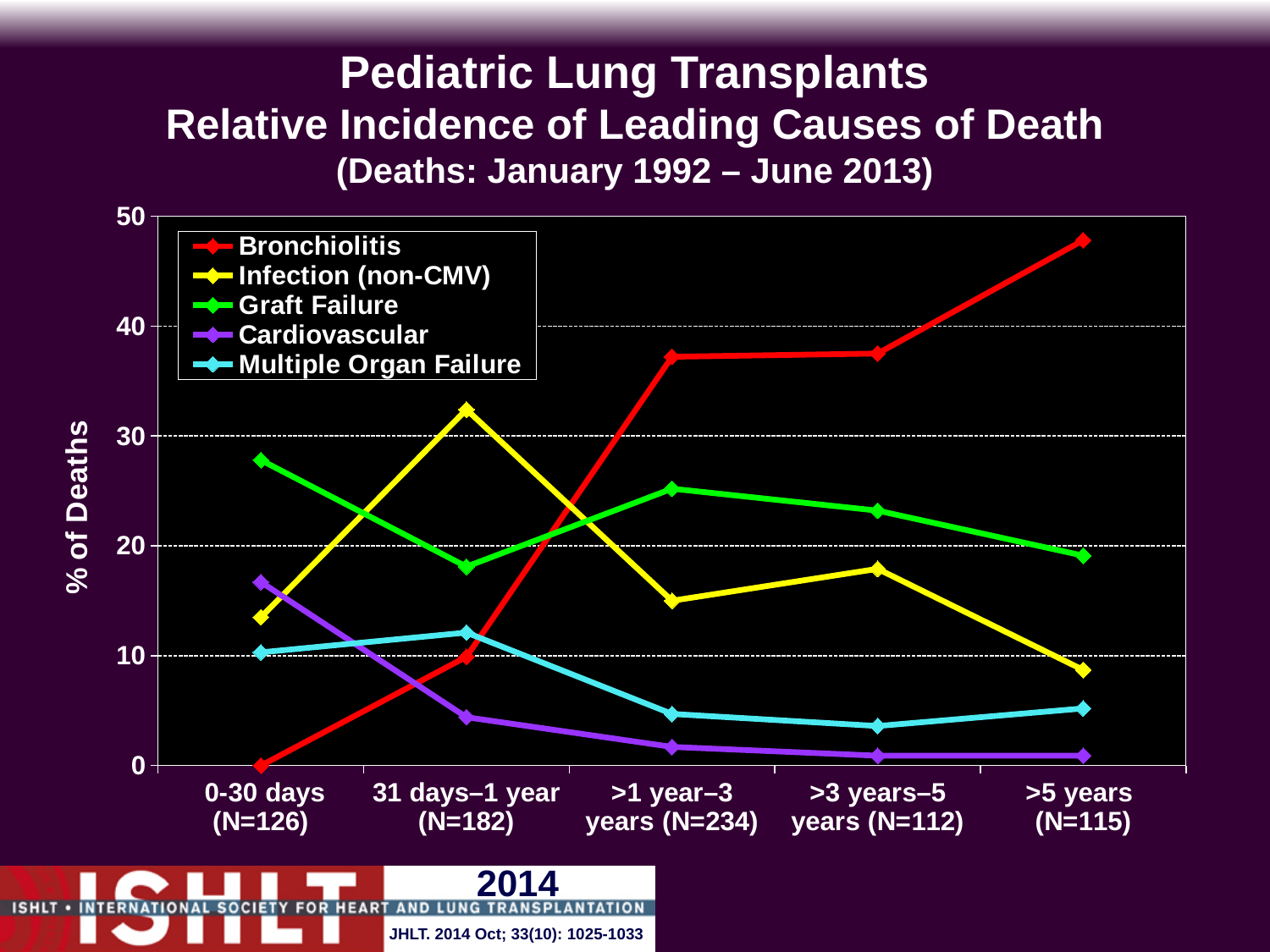
How many time-period categories are shown on the x axis? 5 Is the value for Infection (non-CMV) in the >5 years (N=115) period greater or less than 10? less Is the value for Bronchiolitis in the >5 years (N=115) period greater or less than 40? greater How many series does the legend list? 5 Which cause of death has the highest % of deaths in the 31 days–1 year (N=182) period? Infection (non-CMV) Which cause of death has the highest % of deaths in the 0-30 days (N=126) period? Graft Failure What is the label of the y axis? % of Deaths Which cause of death has the highest % of deaths in the >5 years (N=115) period? Bronchiolitis What kind of chart is shown on the slide? line chart In the >1 year–3 years (N=234) period, which is larger: Graft Failure or Infection (non-CMV)? Graft Failure Which cause of death has the lowest % of deaths in the >5 years (N=115) period? Cardiovascular Does the Bronchiolitis line rise or fall from 0-30 days to >5 years? rise